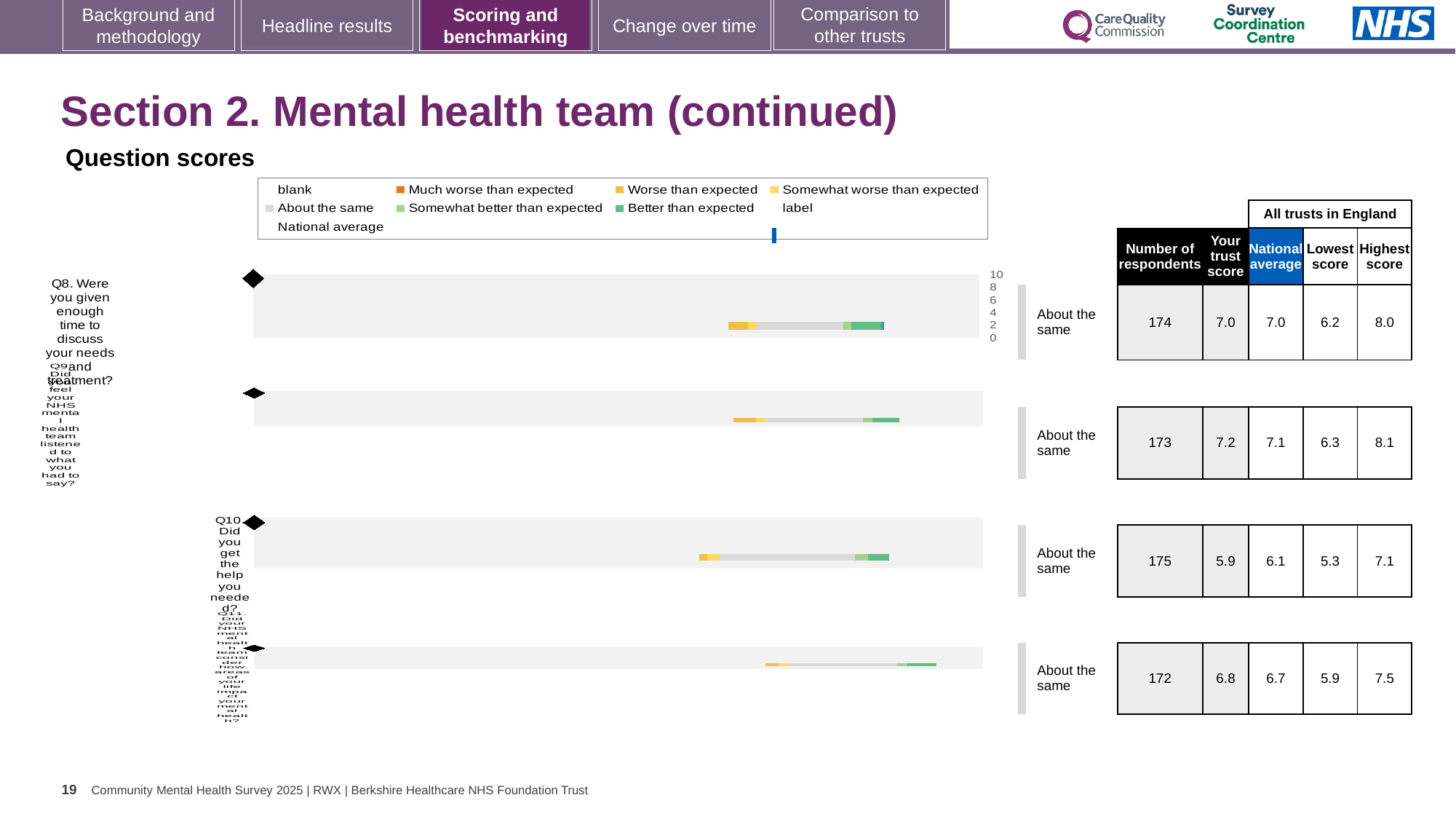
How many question charts are shown on the slide? 4 What kind of chart is used to show the Q8 benchmarking result? bar chart Which question has the highest trust score on the slide? Q9 (7.2) For Q10, what is the difference between the highest score and the lowest score across all trusts in England? 1.8 For Q8, what is the national average score shown? 7.0 For Q9, which is larger: the trust score or the national average? trust score (7.2) What benchmark category is shown next to the Q8 chart? About the same In the legend, what colour represents 'Much worse than expected'? orange For Q8 (Were you given enough time to discuss your needs and treatment?), what is the trust score shown? 7.0 Which question has the lowest trust score on the slide? Q10 (5.9) For Q10 (Did you get the help you needed?), how many respondents are shown? 175